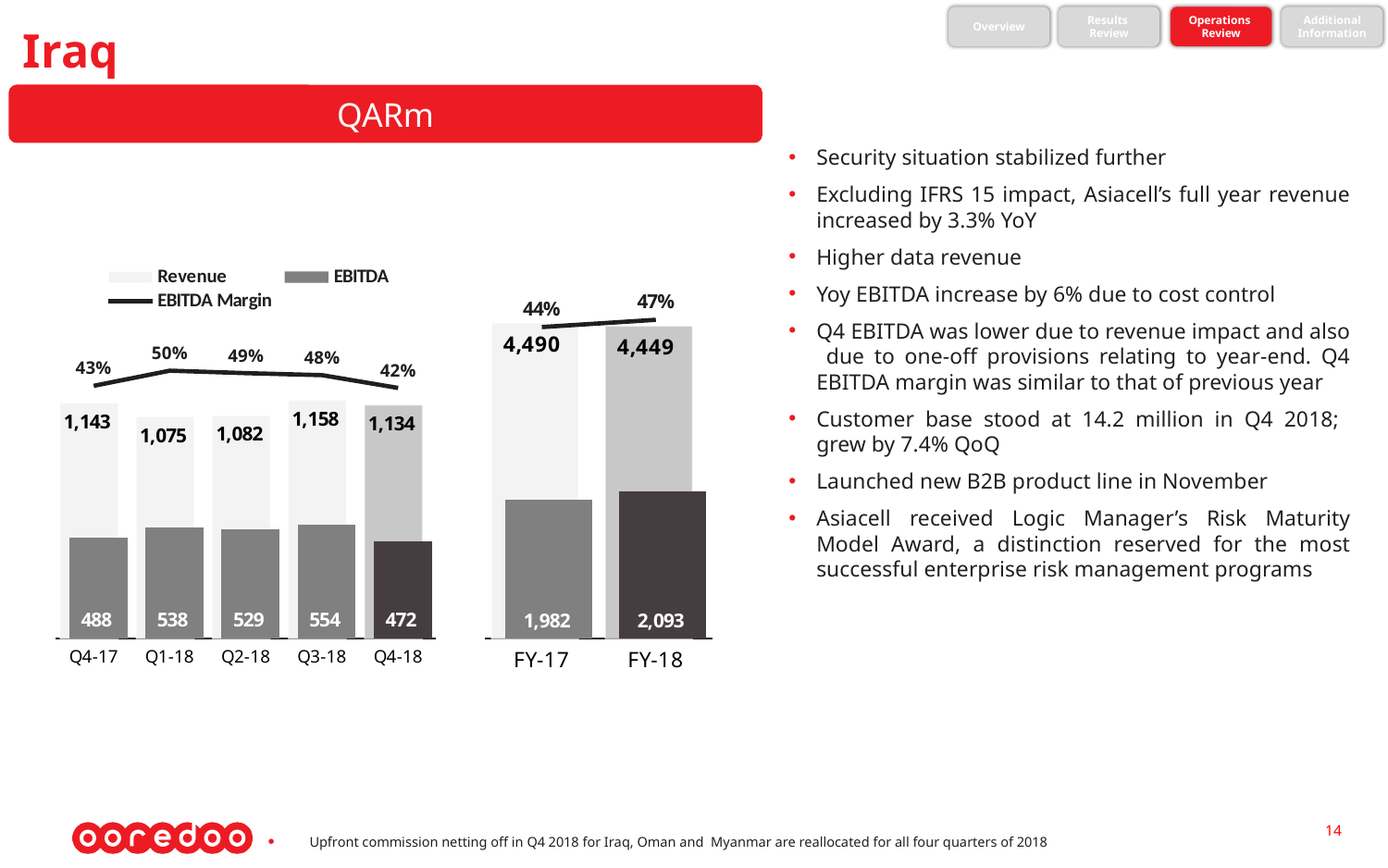
In the quarterly chart on the left, which quarter has the highest EBITDA? Q3-18 In the quarterly chart on the left, what is the EBITDA value for Q1-18? 538 In the quarterly chart on the left, which quarter has the highest EBITDA Margin? Q1-18 In the quarterly chart on the left, which quarter has the lowest Revenue? Q1-18 In the quarterly chart on the left, what is the EBITDA Margin for Q4-18? 42% How many series does the legend of the quarterly chart on the left list? 3 In the quarterly chart on the left, what is the Revenue value for Q3-18? 1,158 How many quarters are shown on the x axis of the quarterly chart on the left? 5 In the full-year chart on the right, what is the difference in EBITDA between FY-18 and FY-17? 111 In the full-year chart on the right, what is the EBITDA value for FY-18? 2,093 In the full-year chart on the right, which year has the higher Revenue, FY-17 or FY-18? FY-17 In the quarterly chart on the left, what is the difference in EBITDA between Q3-18 and Q4-18? 82